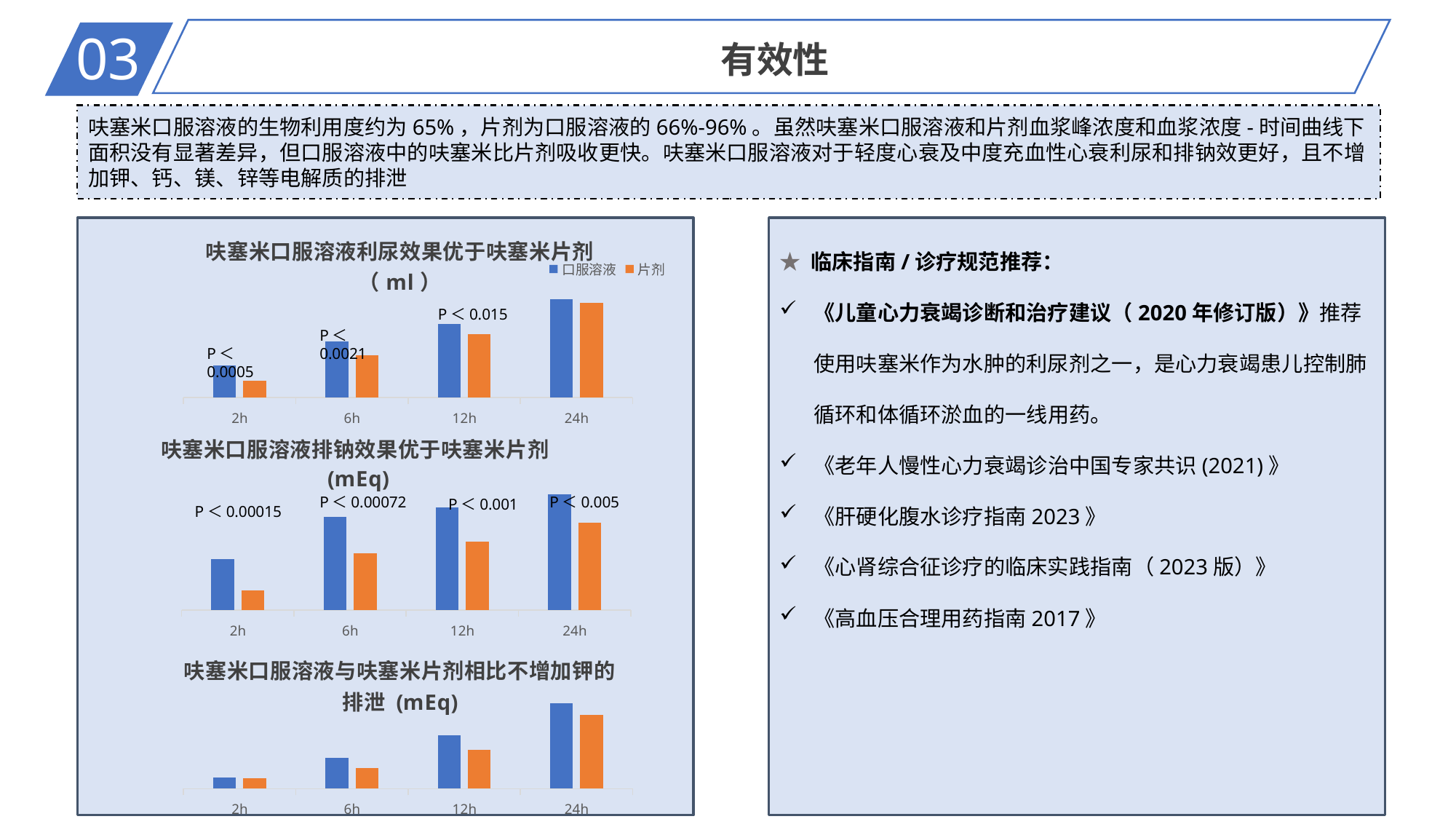
In the top chart (呋塞米口服溶液利尿效果优于呋塞米片剂), what are the two series named in the legend? 口服溶液 and 片剂 In the middle chart (呋塞米口服溶液排钠效果优于呋塞米片剂), at which time point is the 片剂 bar lowest? 2h In the top chart (呋塞米口服溶液利尿效果优于呋塞米片剂), at which time point is the 口服溶液 bar highest? 24h In the top chart (呋塞米口服溶液利尿效果优于呋塞米片剂), how many series does the legend list? 2 In the top chart (呋塞米口服溶液利尿效果优于呋塞米片剂), do the 口服溶液 values rise or fall from 2h to 24h? rise What kind of chart is the top chart titled 呋塞米口服溶液利尿效果优于呋塞米片剂（ml）? bar chart In the middle chart (呋塞米口服溶液排钠效果优于呋塞米片剂), at which time point is the 口服溶液 bar highest? 24h In the top chart (呋塞米口服溶液利尿效果优于呋塞米片剂), how many time-point categories are shown on the x axis? 4 In the middle chart (呋塞米口服溶液排钠效果优于呋塞米片剂), which series has the larger value at 2h, 口服溶液 or 片剂? 口服溶液 In the top chart (呋塞米口服溶液利尿效果优于呋塞米片剂), what P value is printed above the 2h bars? P＜0.0005 In the bottom chart (呋塞米口服溶液与呋塞米片剂相比不增加钾的排泄), at which time point is the 口服溶液 bar lowest? 2h In the bottom chart (呋塞米口服溶液与呋塞米片剂相比不增加钾的排泄), do the 片剂 values rise or fall from 2h to 24h? rise